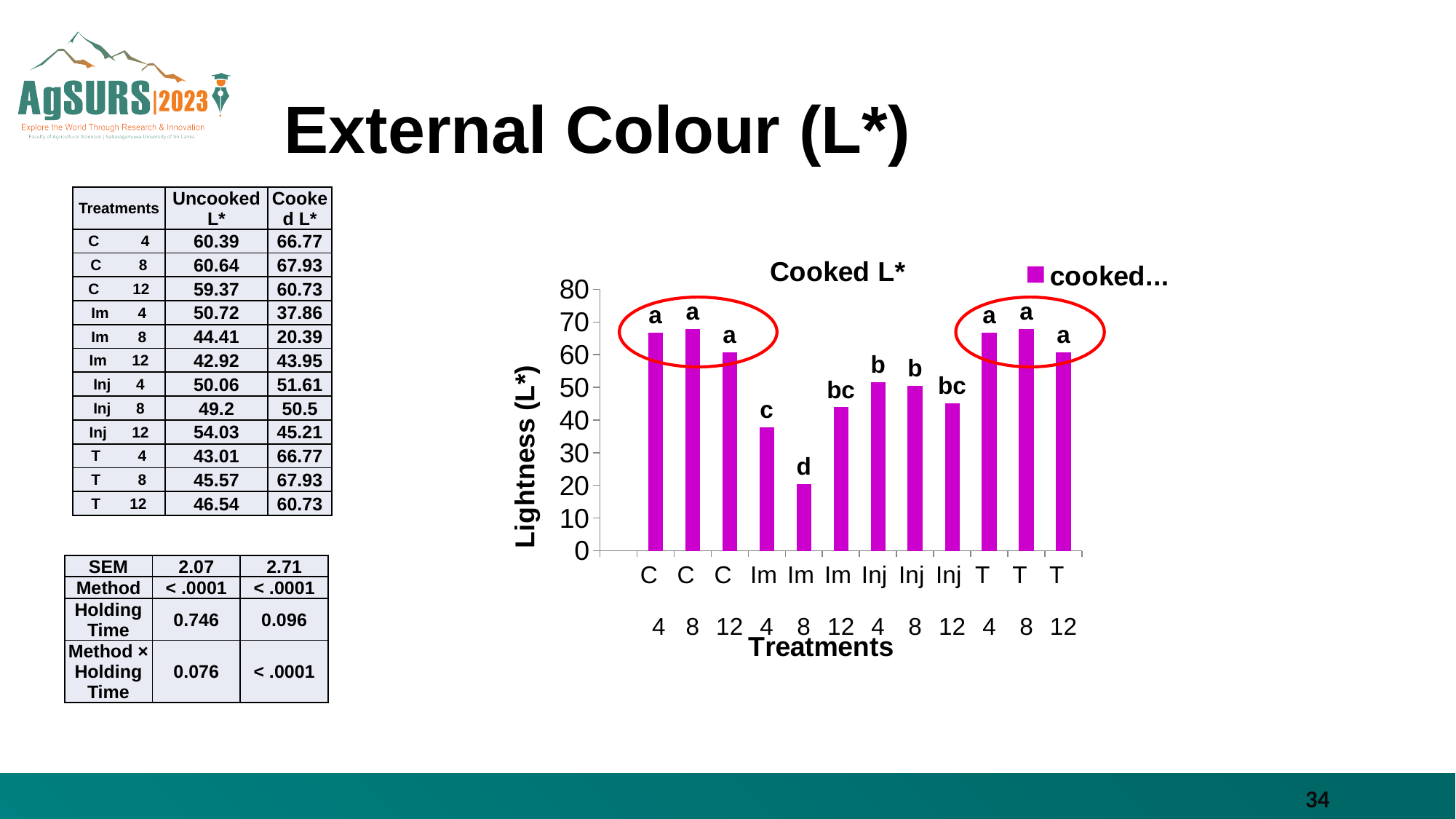
In the Cooked L* chart, is the value for C 4 greater or less than 60? greater What letter label is printed above the Im 8 bar in the Cooked L* chart? d In the Cooked L* chart, is the value for Im 8 greater or less than 30? less How many series does the legend of the Cooked L* chart list? 1 What letter label is printed above the Im 12 bar in the Cooked L* chart? bc In the Cooked L* chart, which is larger, the value for Inj 4 or the value for Im 8? Inj 4 In the Cooked L* chart, is the value for Inj 12 greater or less than 50? less In the Cooked L* chart, which is larger, the value for C 4 or the value for Im 4? C 4 What is the title of the y axis of the chart? Lightness (L*) What kind of chart is shown on the slide? bar chart Which treatment has the lowest bar in the Cooked L* chart? Im 8 How many bars are plotted in the Cooked L* chart? 12